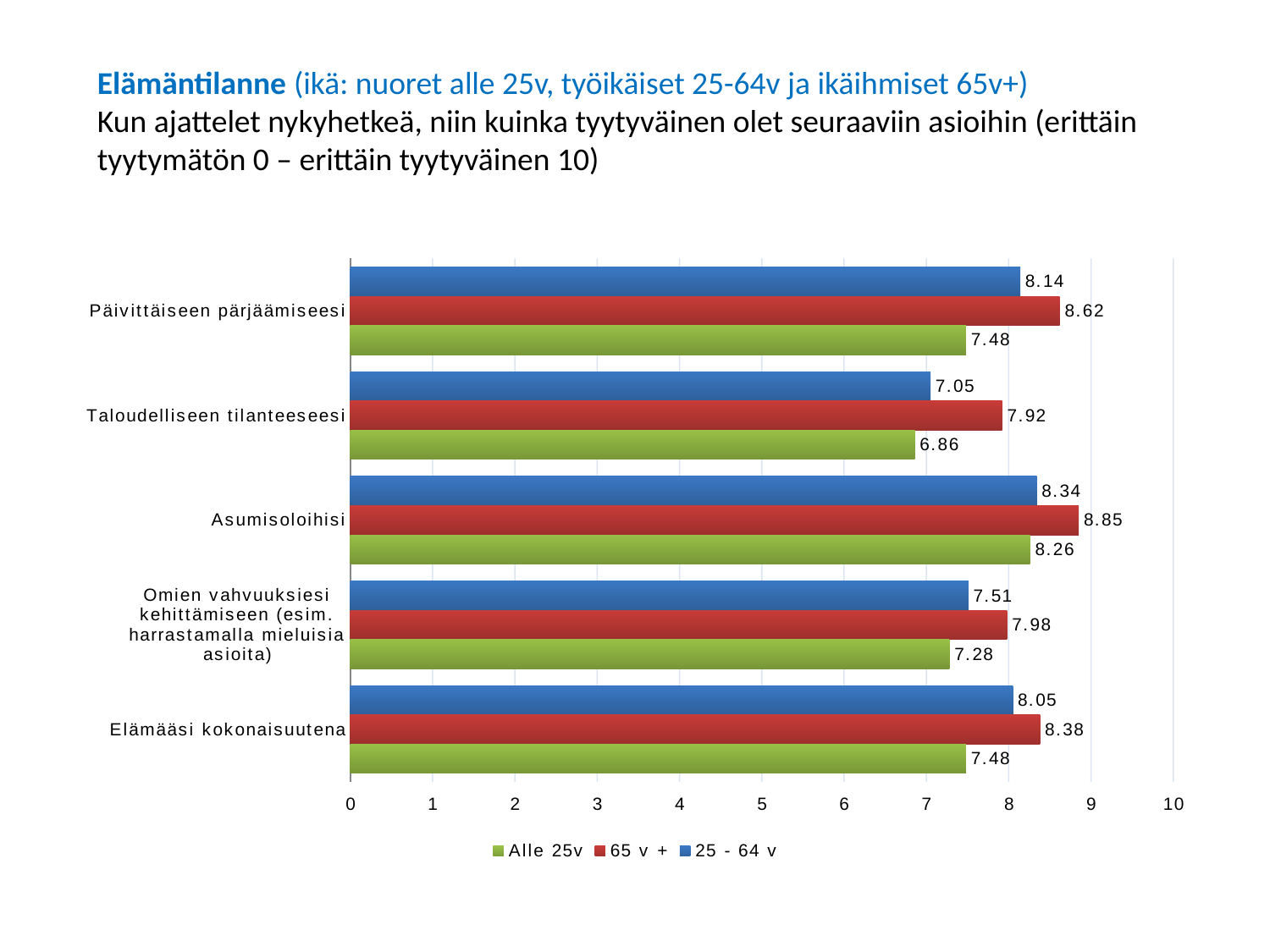
What kind of chart is shown on the slide? bar chart What is the value for '25 - 64 v' in the category 'Elämääsi kokonaisuutena'? 8.05 How many categories are shown on the chart? 5 Is the value for '65 v +' in the category 'Taloudelliseen tilanteeseesi' greater or less than 8? less In the category 'Omien vahvuuksiesi kehittämiseen', which series has the larger value: '25 - 64 v' or 'Alle 25v'? 25 - 64 v Which category has the highest value for the '65 v +' series? Asumisoloihisi What is the value for 'Alle 25v' in the category 'Taloudelliseen tilanteeseesi'? 6.86 What is the value for '65 v +' in the category 'Asumisoloihisi'? 8.85 How many series does the legend list? 3 What is the difference between the '65 v +' and 'Alle 25v' values in the category 'Päivittäiseen pärjäämiseesi'? 1.14 Which category has the lowest value for the '25 - 64 v' series? Taloudelliseen tilanteeseesi Which colour represents the 'Alle 25v' series in the chart? green